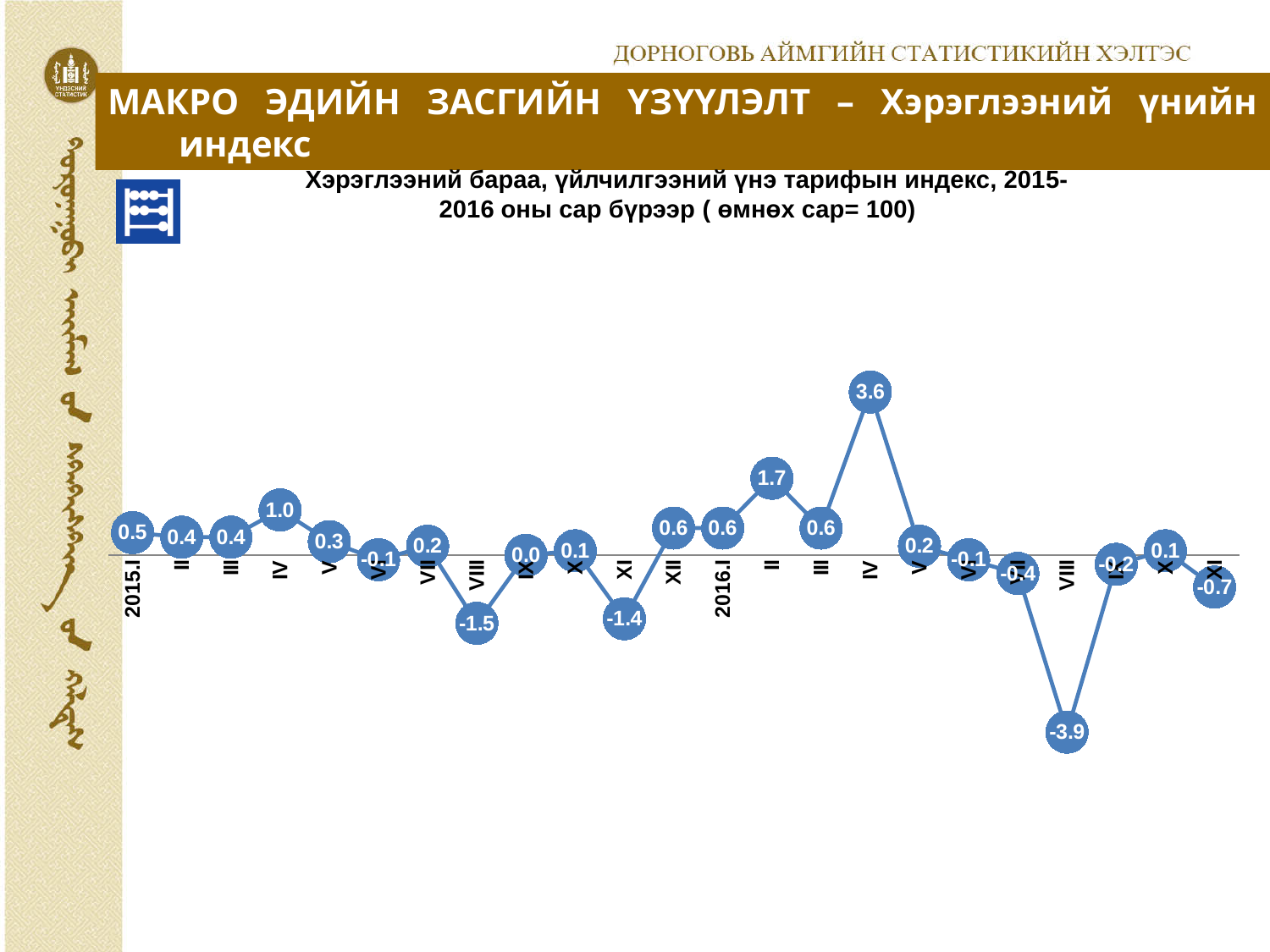
How many data points are plotted on the chart? 23 What is the value for 2016.II? 1.7 What is the difference between the values for 2015.I and 2015.V? 0.2 Which month has the lowest value? 2016.VIII What is the value for 2016.IV? 3.6 Which is larger, the value for 2015.XI or the value for 2015.VIII? 2015.XI What is the value for 2015.VIII? -1.5 What is the value for 2016.XI, the last point on the chart? -0.7 What kind of chart is shown on the slide? line chart Which month has the highest value? 2016.IV What is the difference between the values for 2016.IV and 2016.II? 1.9 What is the value for 2015.IV? 1.0